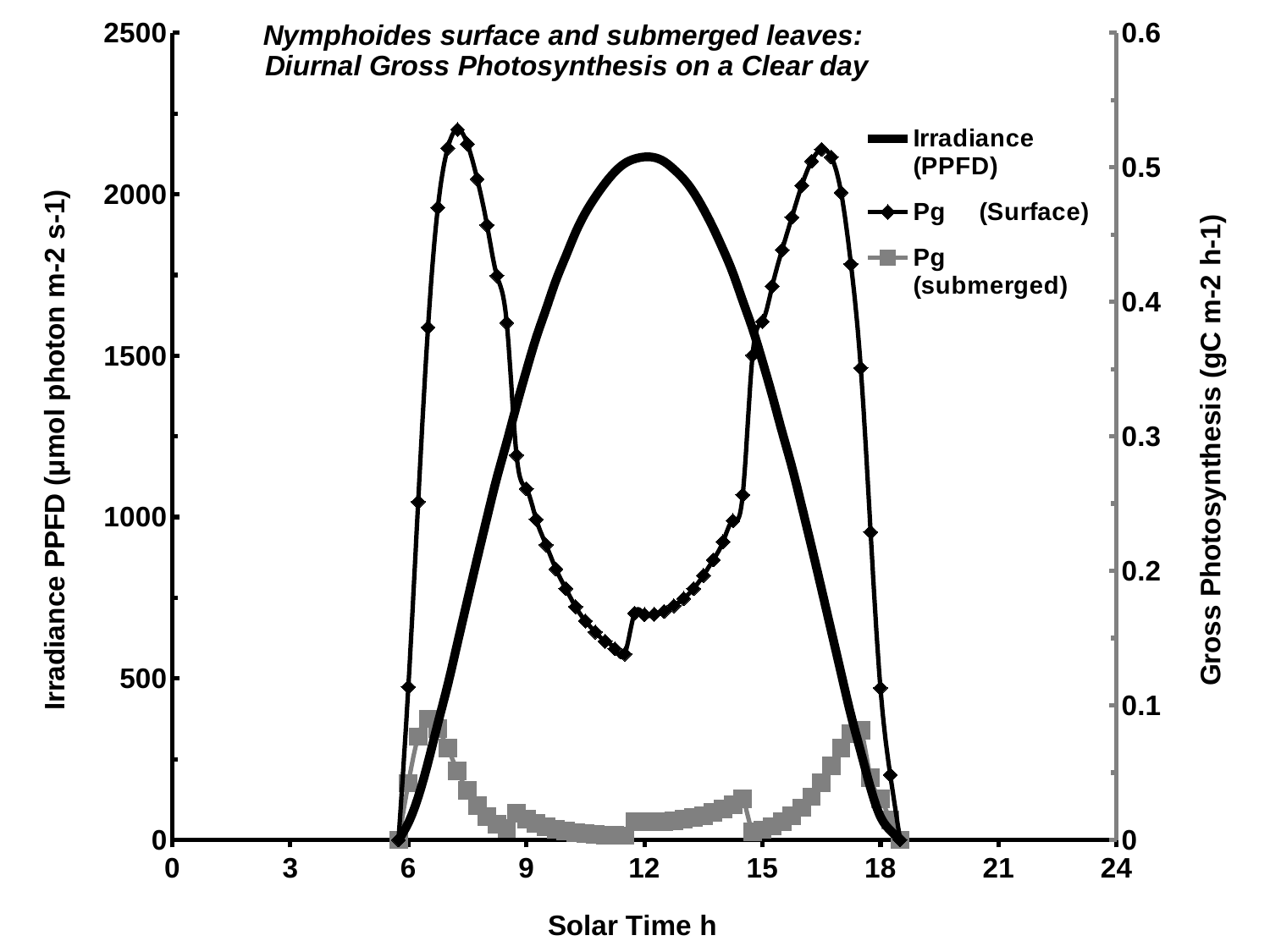
Is the Pg (submerged) value at 12 h greater or less than 0.1 on the right axis? less What is the label of the right-hand y axis? Gross Photosynthesis (gC m-2 h-1) At 12 h, which is higher: Pg (Surface) or Pg (submerged)? Pg (Surface) Is the Pg (Surface) value at 12 h greater or less than 0.2 on the right axis? less Does the Irradiance (PPFD) curve rise or fall between 6 h and 12 h? rise Is the Irradiance (PPFD) value at 9 h greater or less than 1000? greater What kind of chart is shown on the slide? line chart How many series does the legend list? 3 What is the title of the chart? Nymphoides surface and submerged leaves: Diurnal Gross Photosynthesis on a Clear day Does the Pg (Surface) curve rise or fall between 7 h and 11 h? fall